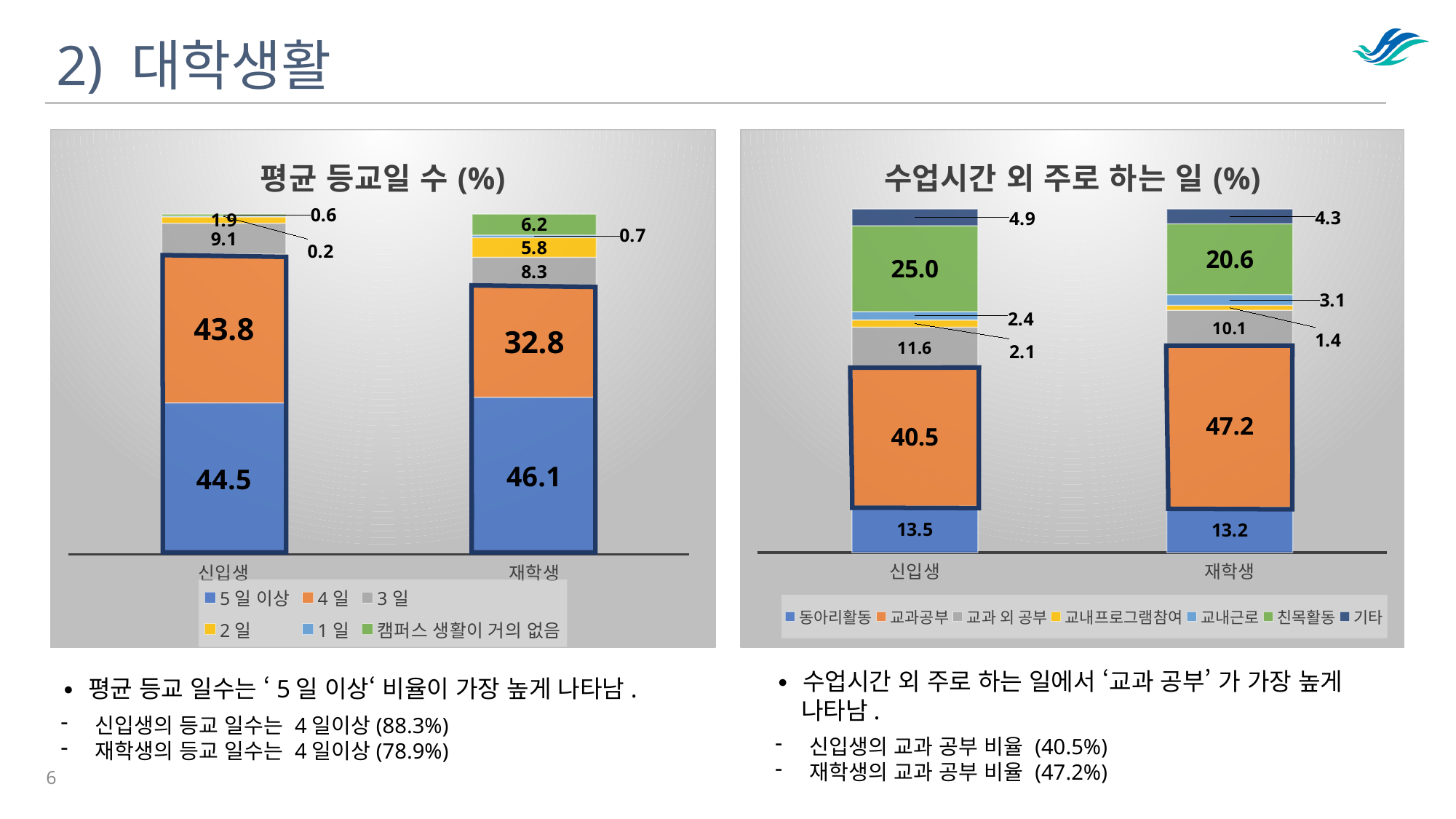
In the chart titled 수업시간 외 주로 하는 일 (%), what is the value of 친목활동 for 신입생? 25.0 In the chart titled 수업시간 외 주로 하는 일 (%), which is larger, 동아리활동 for 신입생 or 동아리활동 for 재학생? 신입생 In the chart titled 평균 등교일 수 (%), what is the difference between the 4 일 values for 신입생 and 재학생? 11.0 In the chart titled 평균 등교일 수 (%), what is the value of 5 일 이상 for 재학생? 46.1 In the chart titled 평균 등교일 수 (%), what is the value of 캠퍼스 생활이 거의 없음 for 재학생? 6.2 In the chart titled 평균 등교일 수 (%), what is the value of 4 일 for 신입생? 43.8 In the chart titled 평균 등교일 수 (%), which series has the highest value for 신입생? 5 일 이상 In the chart titled 수업시간 외 주로 하는 일 (%), how many series does the legend list? 7 What kind of chart is the chart titled 수업시간 외 주로 하는 일 (%)? stacked bar chart In the chart titled 수업시간 외 주로 하는 일 (%), what is the difference between the 친목활동 values for 신입생 and 재학생? 4.4 In the chart titled 수업시간 외 주로 하는 일 (%), what is the value of 교과공부 for 재학생? 47.2 In the chart titled 평균 등교일 수 (%), how many series does the legend list? 6